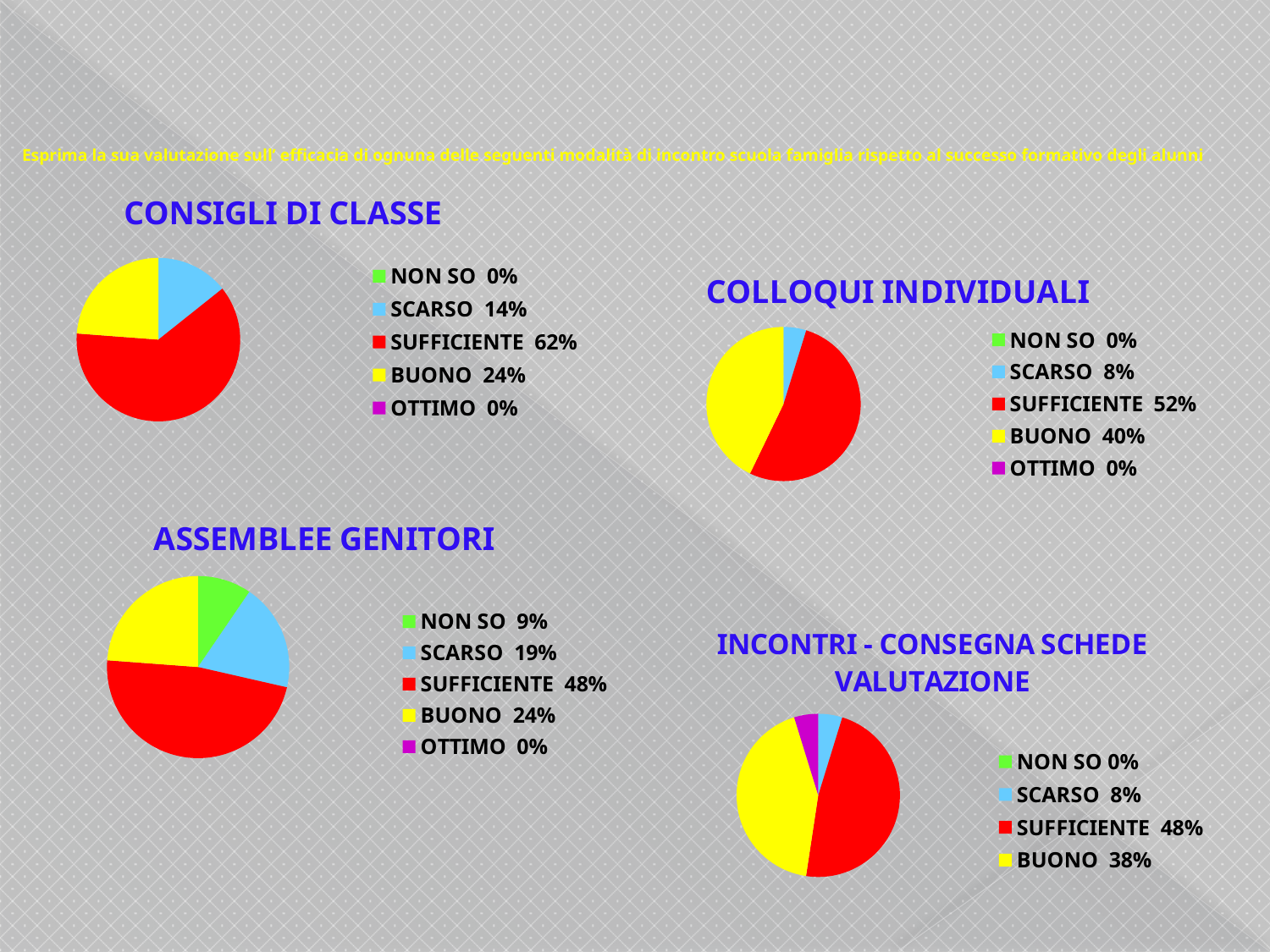
In the CONSIGLI DI CLASSE chart, which category has the largest share? SUFFICIENTE In the COLLOQUI INDIVIDUALI chart, what is the difference between the SUFFICIENTE and BUONO percentages? 12% How many categories does the legend of the COLLOQUI INDIVIDUALI chart list? 5 In the INCONTRI - CONSEGNA SCHEDE VALUTAZIONE chart, what percentage is shown for SCARSO? 8% What type of chart is used for ASSEMBLEE GENITORI? Pie chart In the CONSIGLI DI CLASSE chart, what percentage is shown for SUFFICIENTE? 62% In the ASSEMBLEE GENITORI chart, what is the difference between the SUFFICIENTE and BUONO percentages? 24% In the ASSEMBLEE GENITORI chart, what percentage is shown for NON SO? 9% In the ASSEMBLEE GENITORI chart, which category has the largest share? SUFFICIENTE Which is larger in the CONSIGLI DI CLASSE chart: the share for SCARSO or the share for BUONO? BUONO In the COLLOQUI INDIVIDUALI chart, what percentage is shown for BUONO? 40% How many pie charts are shown on the slide? 4